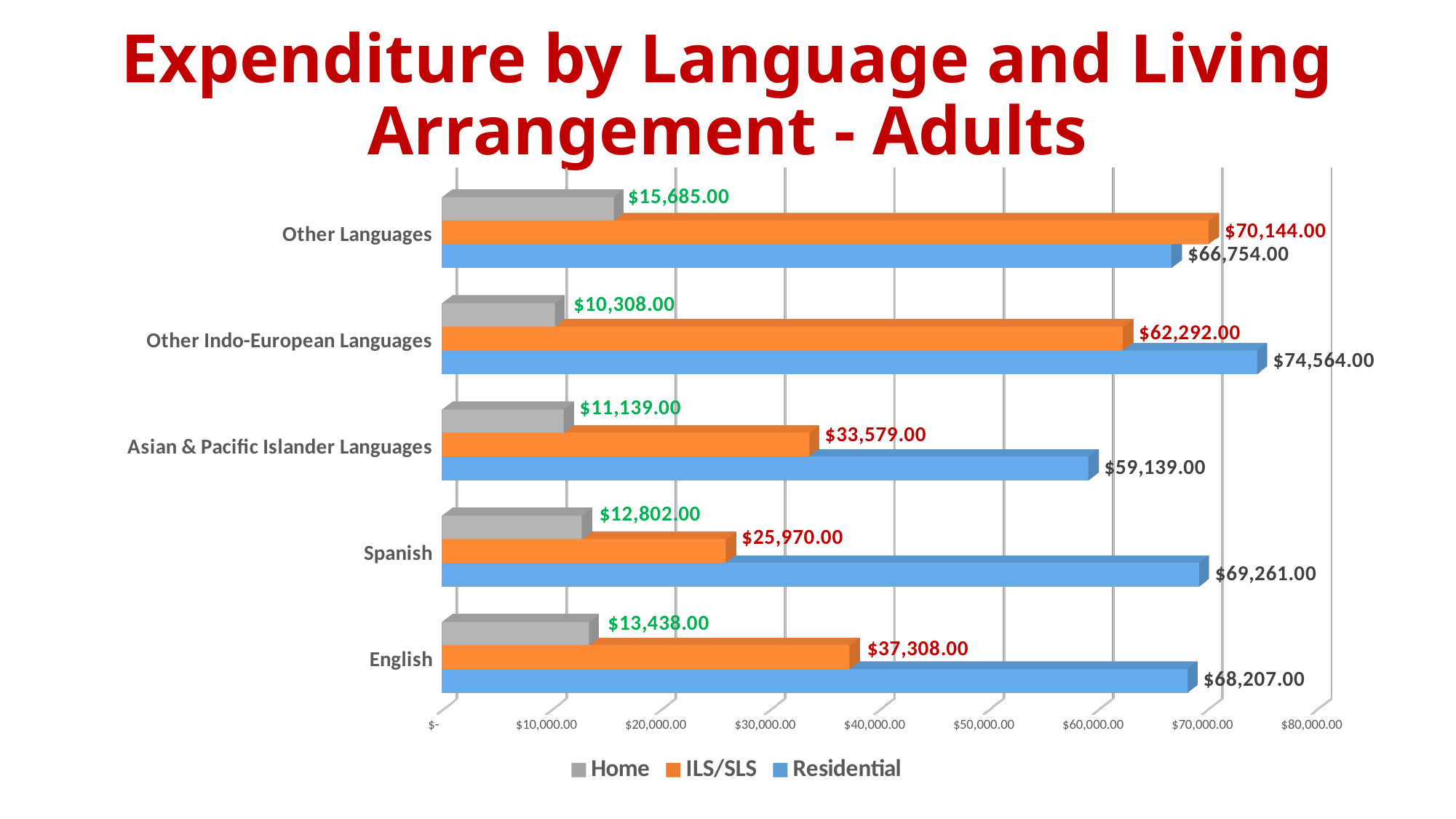
How many language groups are shown on the chart? 5 What is the Home expenditure for Spanish? $12,802.00 Which language group has the highest Residential expenditure? Other Indo-European Languages Which language group has the highest ILS/SLS expenditure? Other Languages What is the ILS/SLS expenditure for Asian & Pacific Islander Languages? $33,579.00 What is the Residential expenditure for English? $68,207.00 What kind of chart is shown on the slide? Bar chart Which language group has the lowest Home expenditure? Other Indo-European Languages For Other Languages, which is larger: the ILS/SLS expenditure or the Residential expenditure? ILS/SLS How much greater is the Home expenditure for Other Languages than for English? $2,247.00 How many series does the legend list? 3 For Spanish, how much greater is the Residential expenditure than the ILS/SLS expenditure? $43,291.00